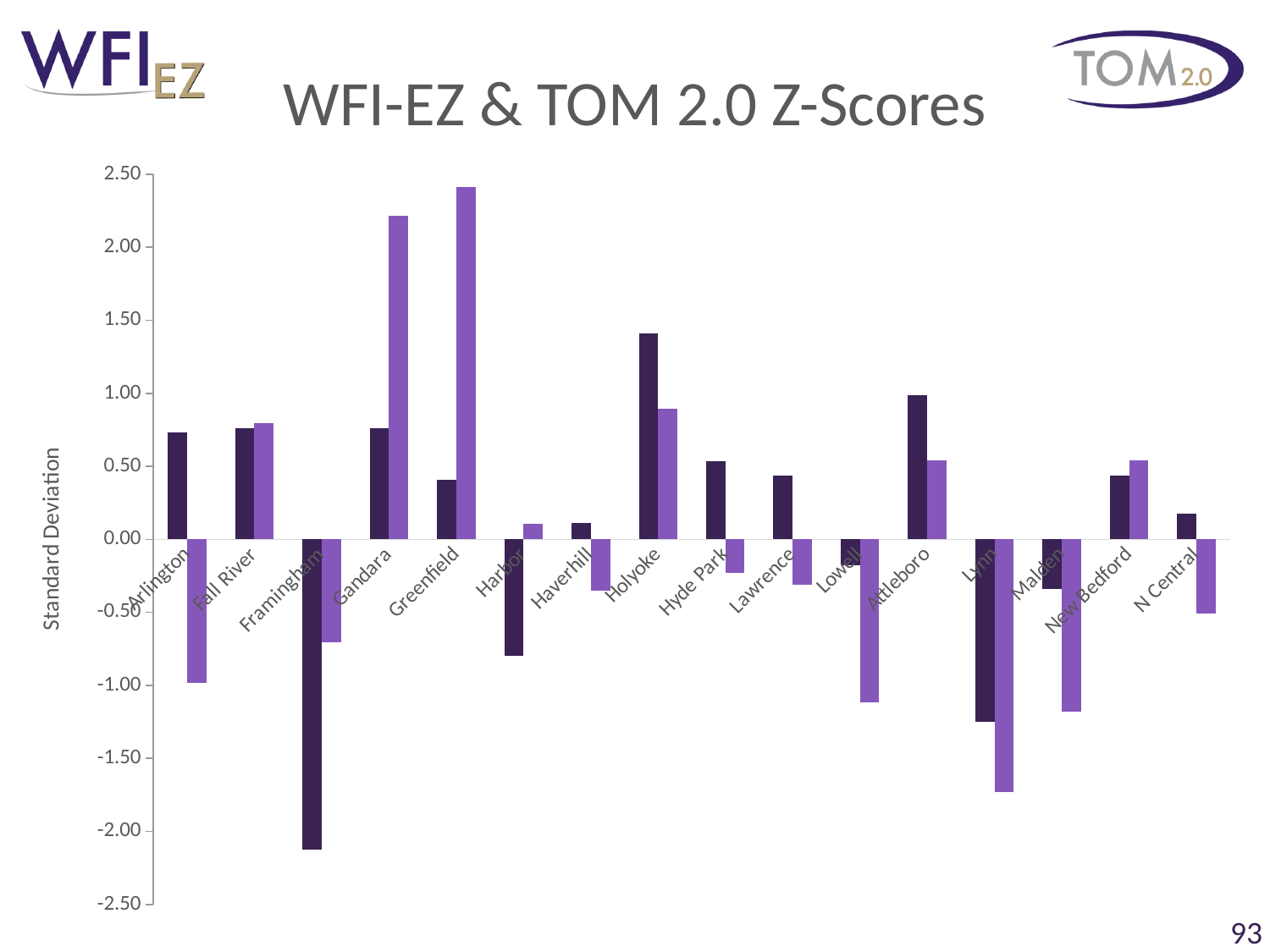
For Gandara, which bar is larger, the dark purple or the light purple? light purple What kind of chart is shown on the slide? bar chart What is the title of the chart? WFI-EZ & TOM 2.0 Z-Scores Among the light purple bars, which category is lowest? Lynn How many categories (sites) are shown along the x axis? 16 Among the dark purple bars, which category is highest? Holyoke Is the light purple value for Greenfield greater or less than 2.00? greater Which category has the lowest bar on the chart? Framingham What is the label on the vertical axis? Standard Deviation Is the dark purple value for Framingham greater or less than -2.00? less Is the light purple value for Lowell greater or less than -1.00? less Which category has the highest bar on the chart? Greenfield